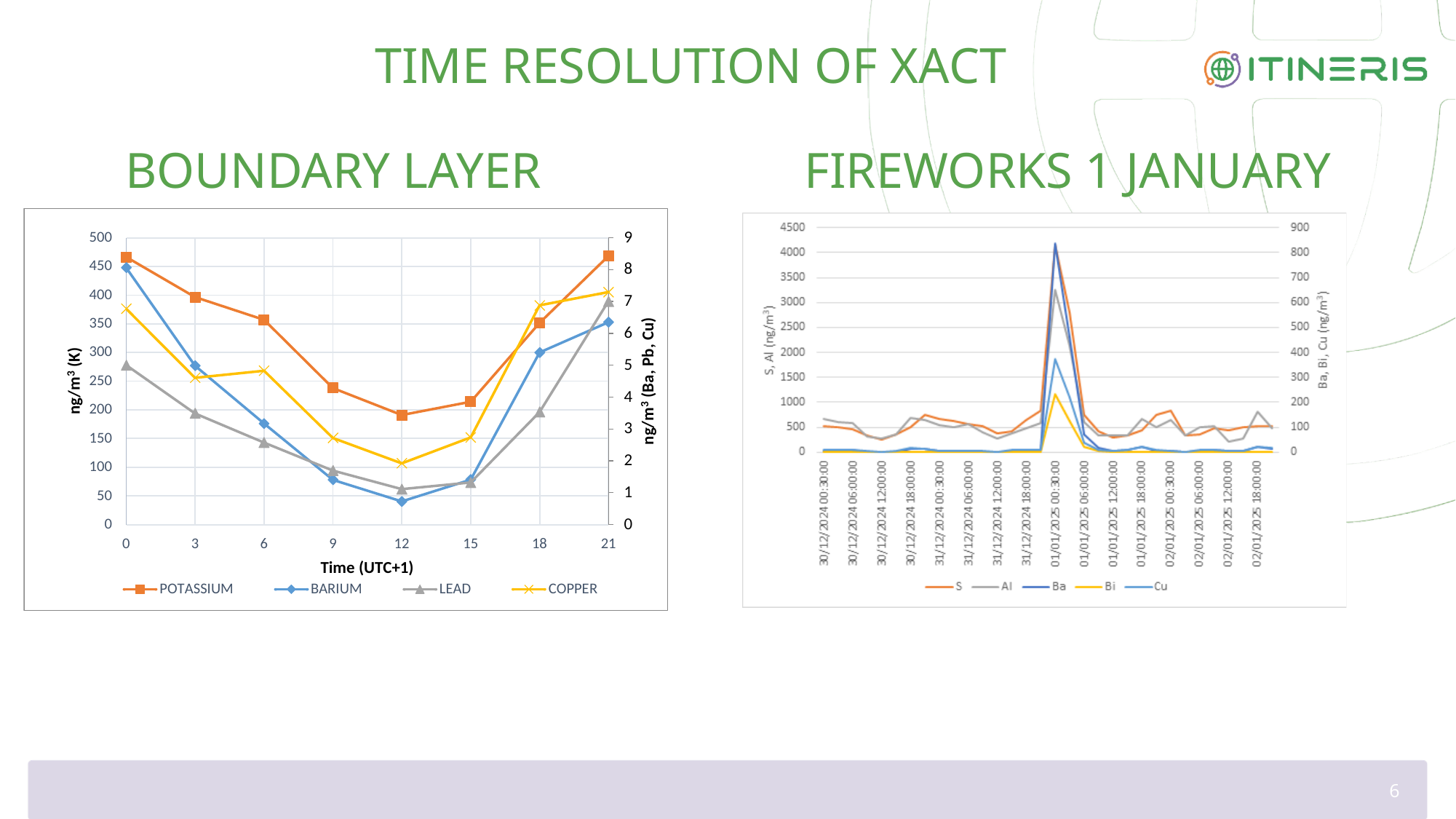
How many series does the legend of the Boundary Layer chart list? 4 How many series does the legend of the Fireworks 1 January chart list? 5 In the Boundary Layer chart, does the Potassium value rise or fall from time 0 to time 12? fall In the Boundary Layer chart, which is larger at time 0, Barium or Copper? Barium In the Boundary Layer chart, is the Potassium value at time 0 greater or less than 400? greater How many time points are plotted along the x axis of the Boundary Layer chart? 8 In the Boundary Layer chart, at which time is the Barium value lowest? 12 In the Boundary Layer chart, at which time is the Potassium value lowest? 12 In the Boundary Layer chart, is the Copper value at time 12 greater or less than 3 on the right axis? less In the Fireworks 1 January chart, is the peak value of the Ba series greater or less than 700 on the right axis? greater What type of chart is the Boundary Layer chart? line chart In the Fireworks 1 January chart, at which time does the Ba series reach its peak? 01/01/2025 00:30:00